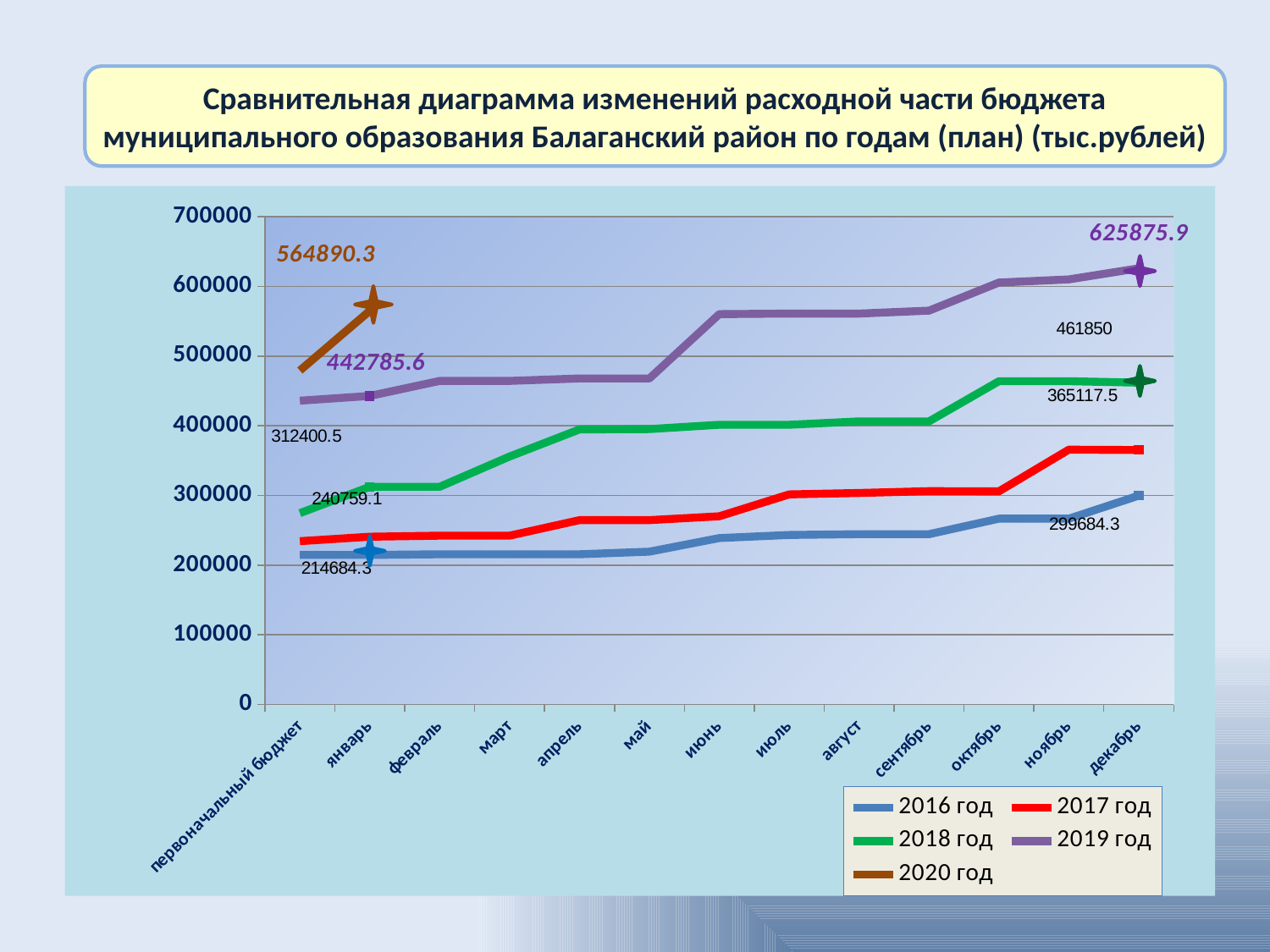
What is the value for 2017 год in декабрь? 365117.5 How many categories are on the x axis? 13 What is the value for 2018 год in декабрь? 461850 Which is larger: the 2019 год value in декабрь or the 2020 год value in январь? 2019 год in декабрь What is the value for 2020 год in январь? 564890.3 How many series does the legend list? 5 Which series has the highest value in декабрь? 2019 год What kind of chart is shown on the slide? line chart Is the value for 2016 год in июнь greater or less than 300000? less What is the difference between the 2019 год values in декабрь and январь? 183090.3 What is the value for 2019 год in январь? 442785.6 What is the value for 2019 год in декабрь? 625875.9